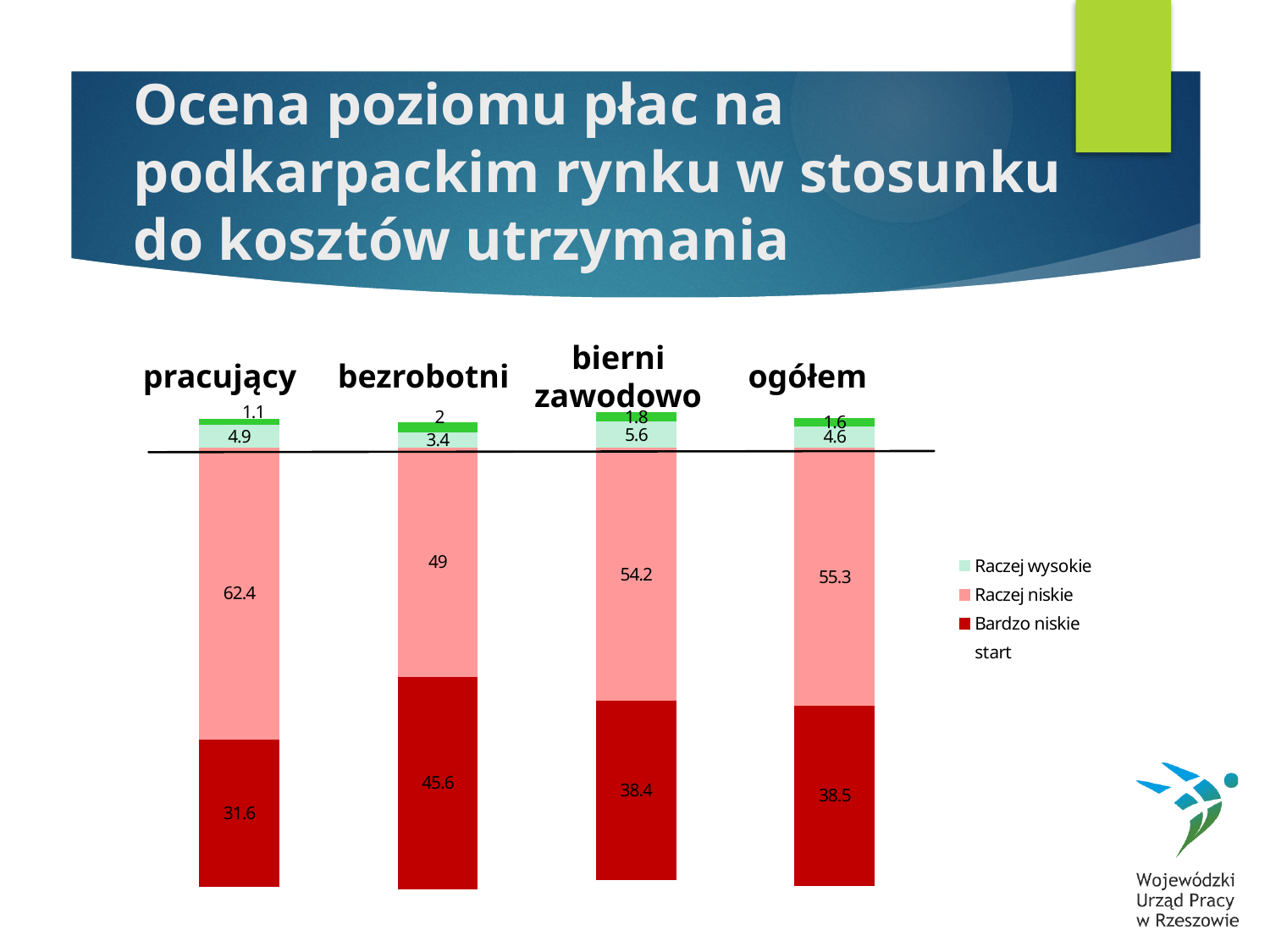
How many categories are shown on the x axis? 4 Which category has the lowest Raczej niskie value? bezrobotni How many entries does the legend list? 4 Which category has the highest Bardzo niskie value? bezrobotni What is the value of the Raczej niskie segment for ogółem? 55.3 What is the difference between the Raczej niskie values for pracujący and bezrobotni? 13.4 Which is larger: the Bardzo niskie value for pracujący or for bezrobotni? bezrobotni What is the value of the Raczej niskie segment for pracujący? 62.4 What kind of chart is shown on the slide? stacked bar chart What is the value of the Raczej wysokie segment for bierni zawodowo? 5.6 What is the value of the Bardzo niskie segment for bezrobotni? 45.6